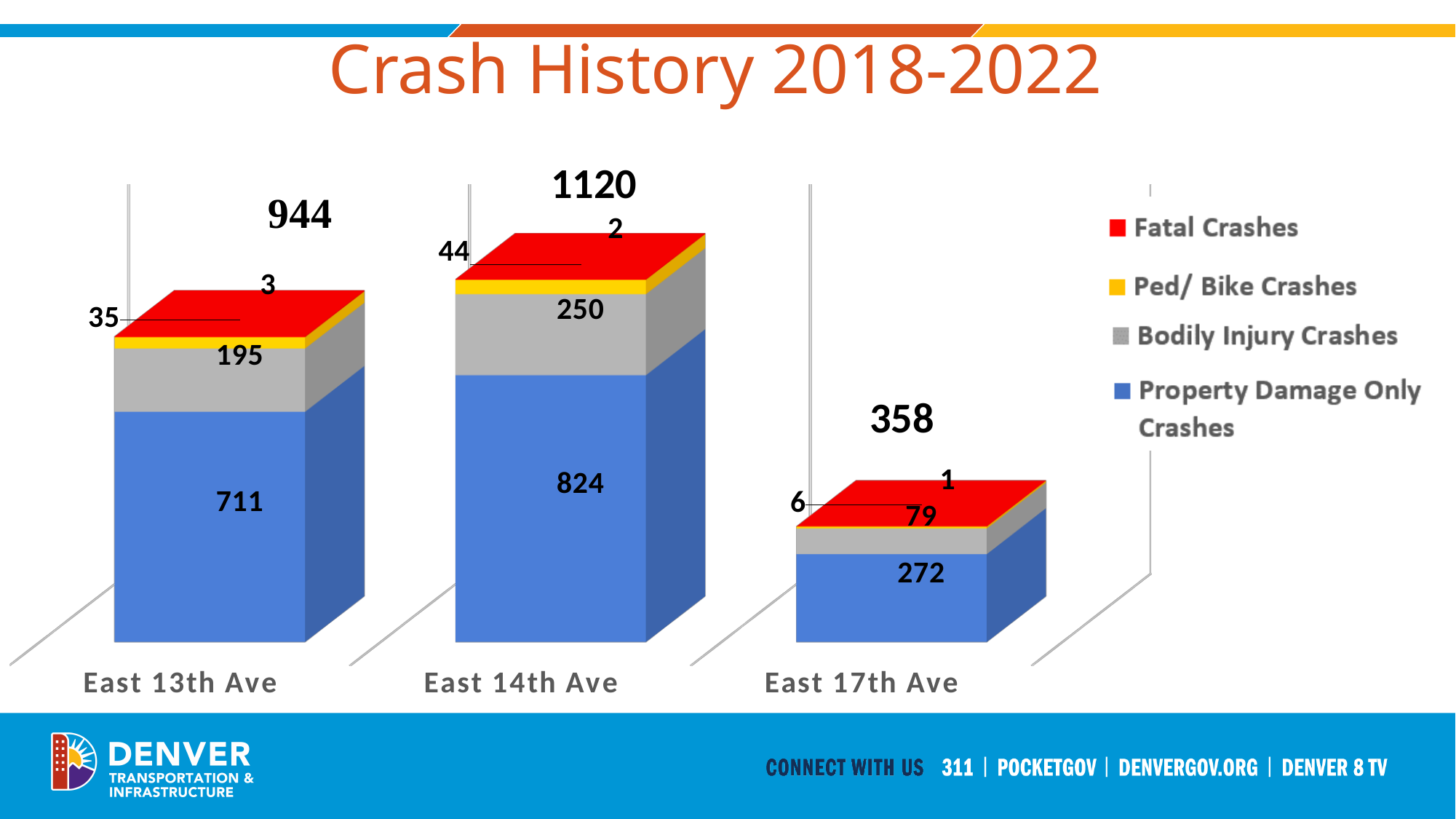
How many Property Damage Only Crashes are shown for East 17th Ave? 272 How many streets are shown on the chart? 3 What is the value for Bodily Injury Crashes on East 13th Ave? 195 How many more Property Damage Only Crashes does East 14th Ave have than East 13th Ave? 113 Which street has the lowest total number of crashes? East 17th Ave How many series does the legend list? 4 Which has more Bodily Injury Crashes, East 14th Ave or East 17th Ave? East 14th Ave How many Property Damage Only Crashes are shown for East 14th Ave? 824 What is the difference between the total crashes on East 14th Ave and East 17th Ave? 762 Which street has the highest total number of crashes? East 14th Ave What is the total number of crashes shown for East 17th Ave? 358 What is the total number of crashes shown for East 13th Ave? 944